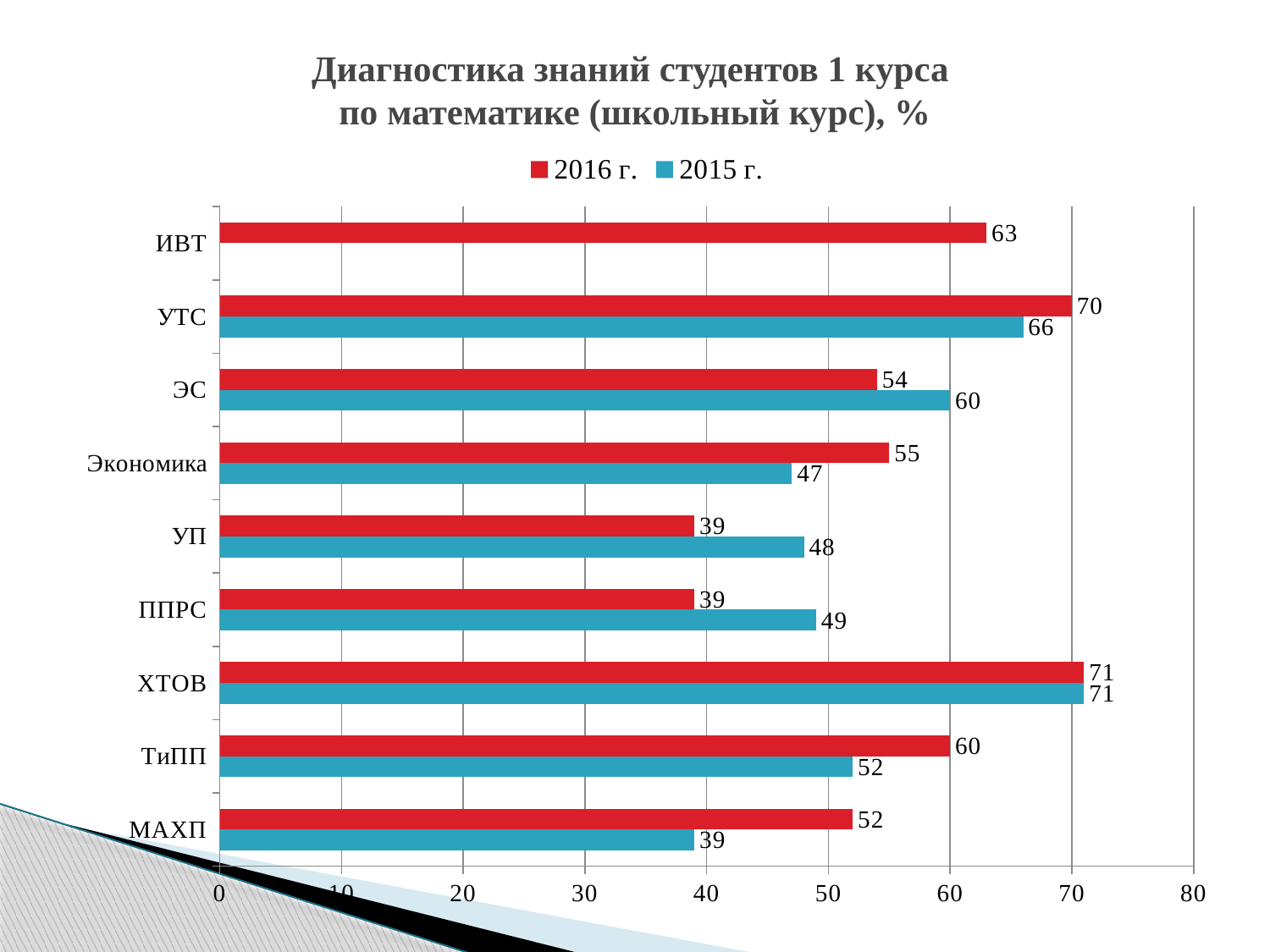
How many categories are shown on the vertical axis? 9 What is the 2015 г. value for Экономика? 47 What is the 2016 г. value for ИВТ? 63 What is the difference between the 2016 г. and 2015 г. values for ТиПП? 8 What is the 2016 г. value for УТС? 70 What kind of chart is shown on the slide? bar chart Which colour represents the 2015 г. series? blue How many series does the legend list? 2 Which is larger for ЭС: the 2016 г. value or the 2015 г. value? 2015 г. Which category has the highest 2015 г. value? ХТОВ Which category has the lowest 2015 г. value? МАХП Is the 2016 г. value for МАХП greater or less than 50? greater